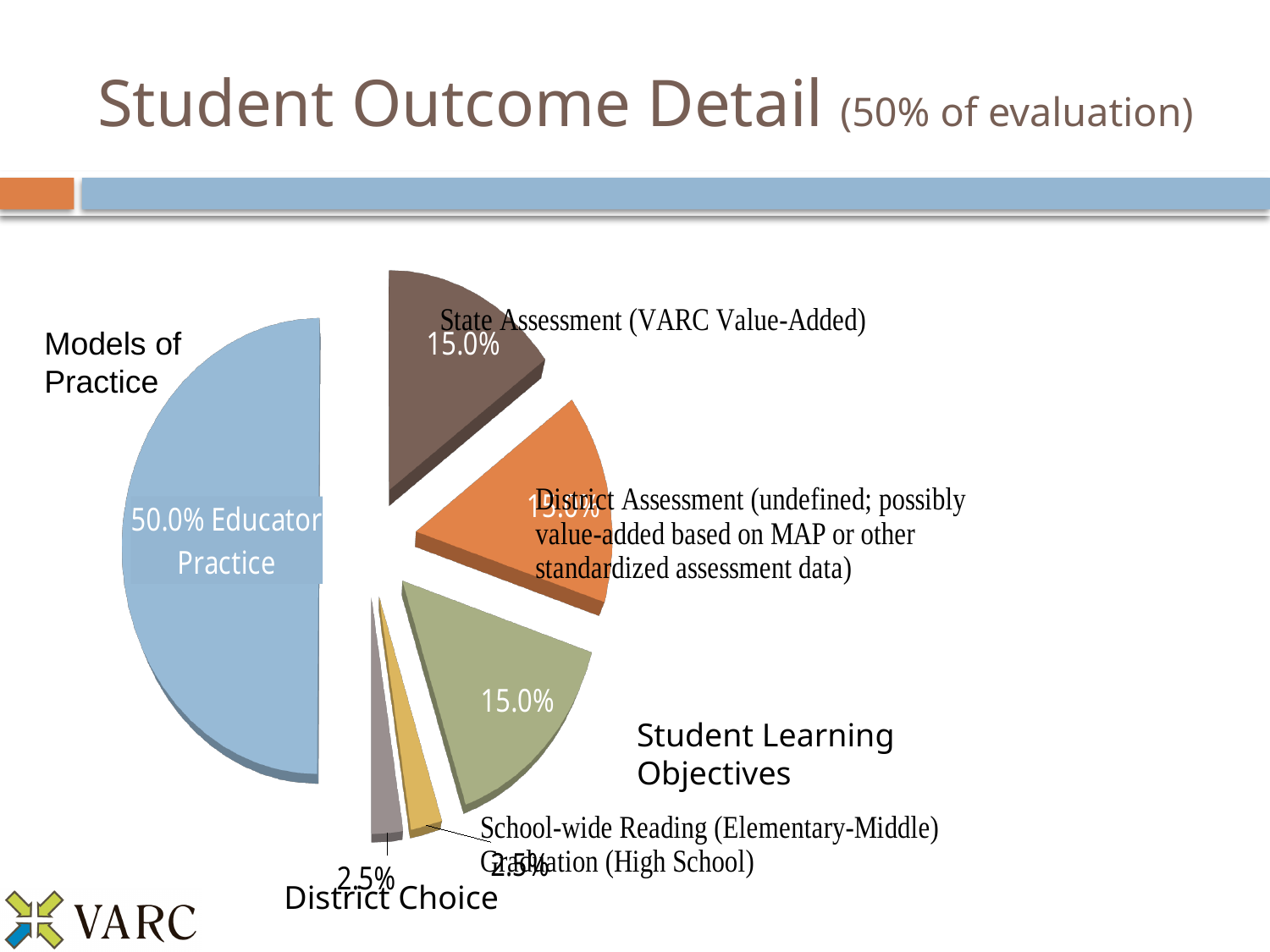
What percentage is shown for the District Choice slice? 2.5% What percentage is shown for the State Assessment (VARC Value-Added) slice? 15.0% What colour is the Educator Practice slice? blue What percentage is shown for the Student Learning Objectives slice? 15.0% What kind of chart is shown on the slide? pie chart What is the difference between the Student Learning Objectives slice and the District Choice slice? 12.5% What percentage of the pie is labelled Educator Practice? 50.0% Which slice of the pie is the largest? Educator Practice How many slices does the pie chart have? 6 What is the title of the slide containing the pie chart? Student Outcome Detail (50% of evaluation) What is the difference between the Educator Practice slice and the State Assessment slice? 35.0% Which is larger, the State Assessment slice or the District Choice slice? State Assessment